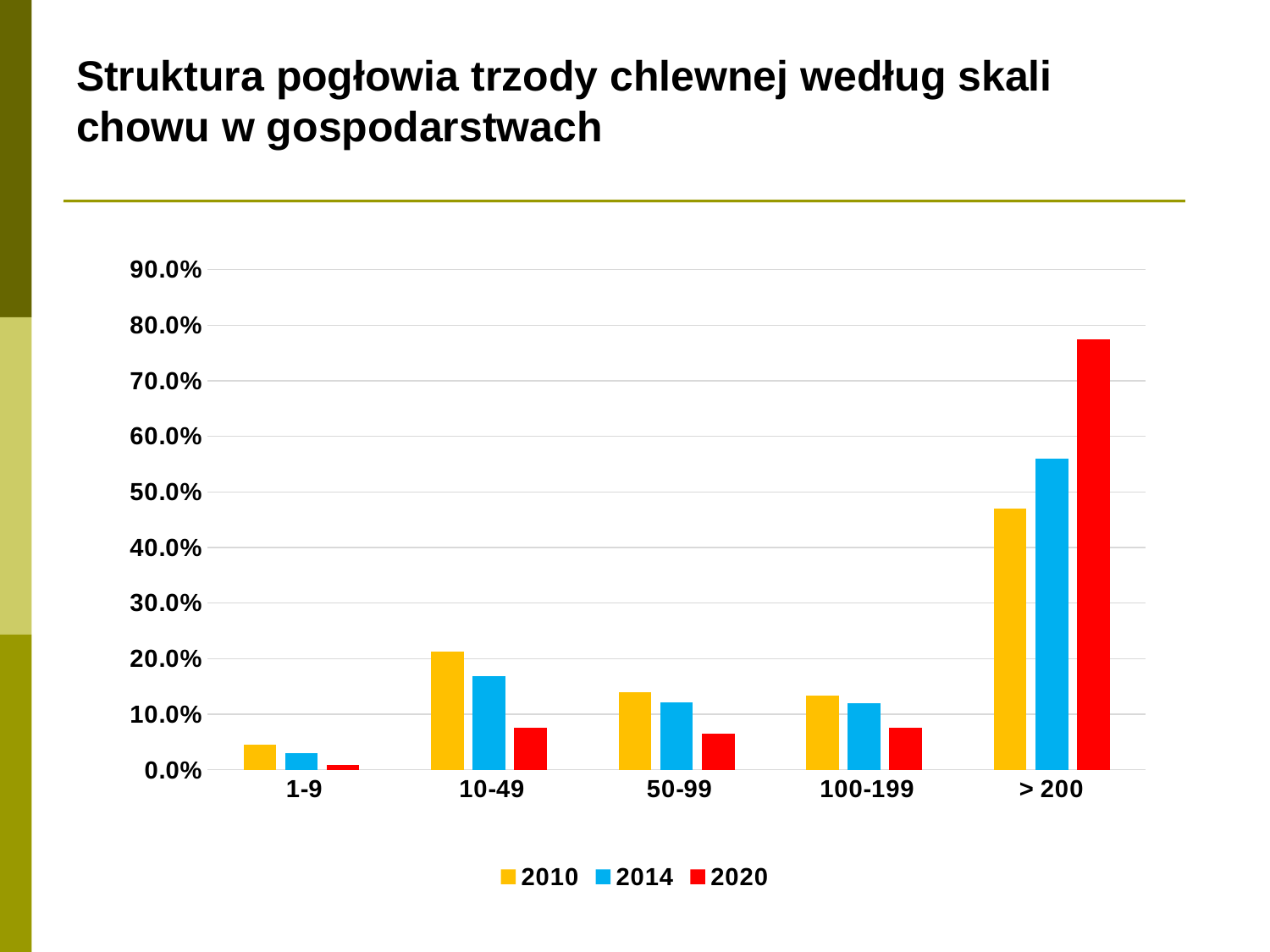
Which category has the highest value for 2020? > 200 Is the value for 2010 in the > 200 category greater or less than 50.0%? less In the 10-49 category, which is larger: the value for 2010 or the value for 2020? 2010 What kind of chart is shown on the slide? bar chart Is the value for 2020 in the > 200 category greater or less than 70.0%? greater In the > 200 category, which is larger: the value for 2010 or the value for 2020? 2020 How many series does the legend list? 3 Which category has the highest value for 2010? > 200 How many categories are shown on the x axis? 5 Which category has the lowest value for 2020? 1-9 Is the value for 2020 in the 10-49 category greater or less than 10.0%? less Do the values for the > 200 category rise or fall from 2010 to 2020? rise